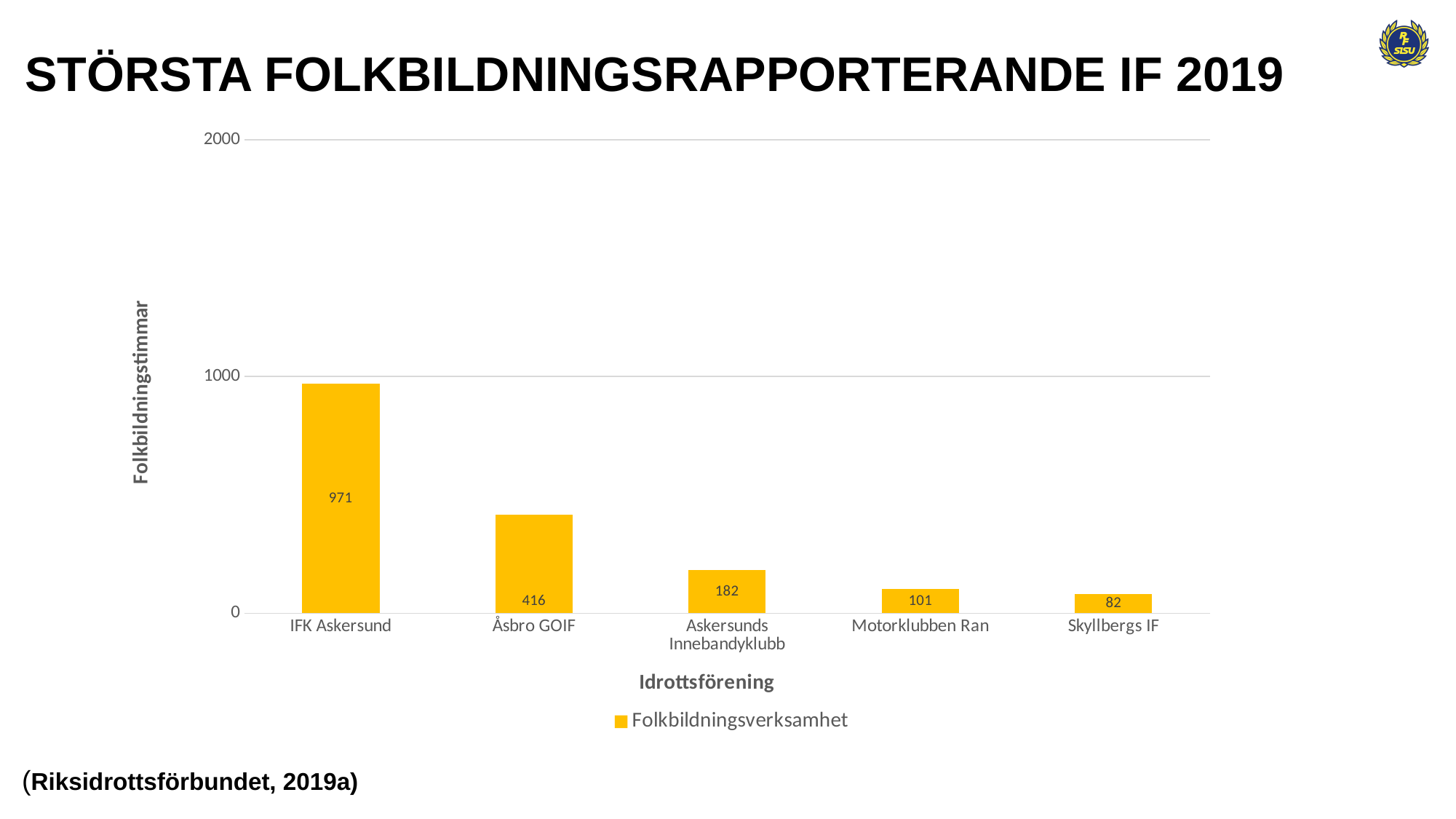
What is the value for Åsbro GOIF? 416 What is the value for IFK Askersund? 971 What is the label of the y axis? Folkbildningstimmar Is the value for IFK Askersund greater or less than 1000? less Which is larger, the value for Motorklubben Ran or the value for Skyllbergs IF? Motorklubben Ran How many categories are shown on the x axis? 5 What is the difference between the values for IFK Askersund and Åsbro GOIF? 555 What kind of chart is shown on the slide? bar chart What is the value for Askersunds Innebandyklubb? 182 Which category has the lowest value? Skyllbergs IF Which category has the highest value? IFK Askersund What is the value for Skyllbergs IF? 82